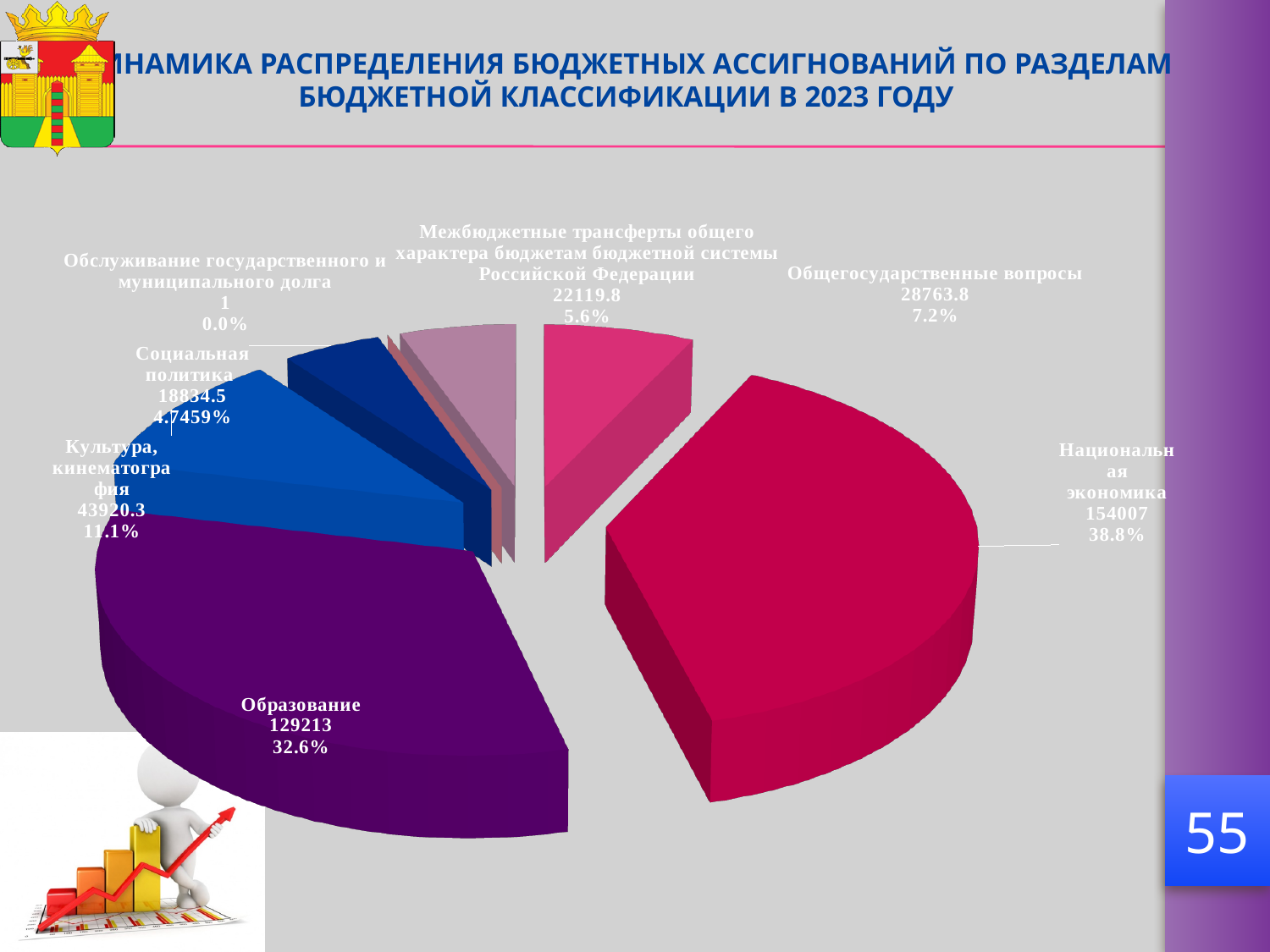
What is the difference between the values for Национальная экономика and Образование? 24794 What is the value for Национальная экономика? 154007 What is the value for Образование? 129213 What is the value for Культура, кинематография? 43920.3 What is the value for Межбюджетные трансферты общего характера бюджетам бюджетной системы Российской Федерации? 22119.8 How many categories (slices) does the pie chart show? 7 Which category has the largest slice of the pie? Национальная экономика Which category has the smallest slice of the pie? Обслуживание государственного и муниципального долга Which is larger, the value for Культура, кинематография or the value for Социальная политика? Культура, кинематография What share of the pie does Общегосударственные вопросы represent? 7.2% What kind of chart is shown on the slide? pie chart What share of the pie does Образование represent? 32.6%